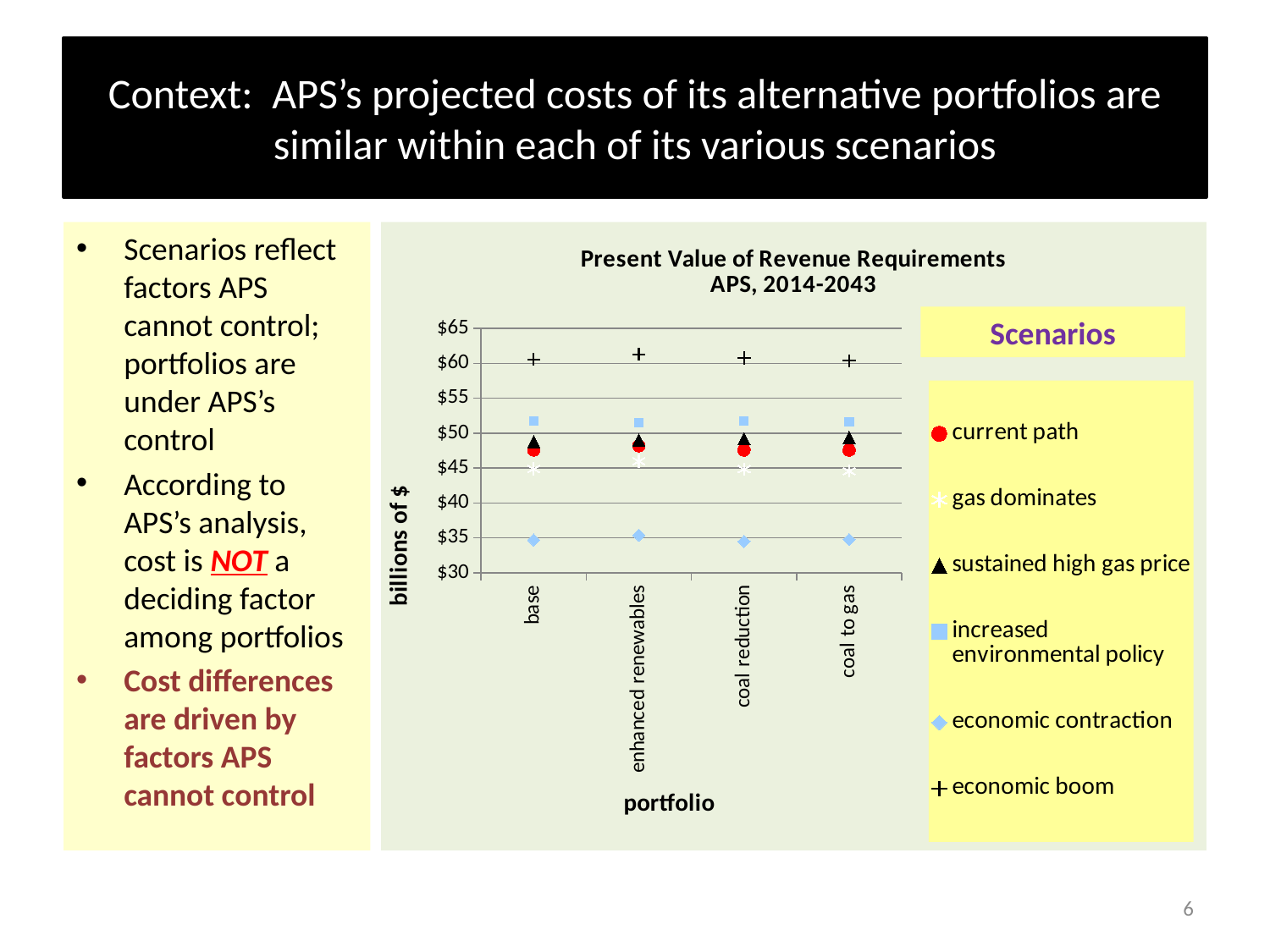
What is the title of the chart? Present Value of Revenue Requirements APS, 2014-2043 Which scenario has the lowest value for the coal to gas portfolio? economic contraction Is the value for the economic contraction scenario at the base portfolio greater or less than $40? less How many portfolios are shown on the x axis of the chart? 4 For the enhanced renewables portfolio, which is larger: the economic contraction value or the gas dominates value? gas dominates Is the value for the current path scenario at the coal reduction portfolio greater or less than $50? less Is the value for the increased environmental policy scenario at the enhanced renewables portfolio greater or less than $55? less How many scenario series does the chart's legend list? 6 Which scenario has the highest value for the base portfolio? economic boom What is the label on the chart's vertical axis? billions of $ For the coal to gas portfolio, which is larger: the economic boom value or the sustained high gas price value? economic boom